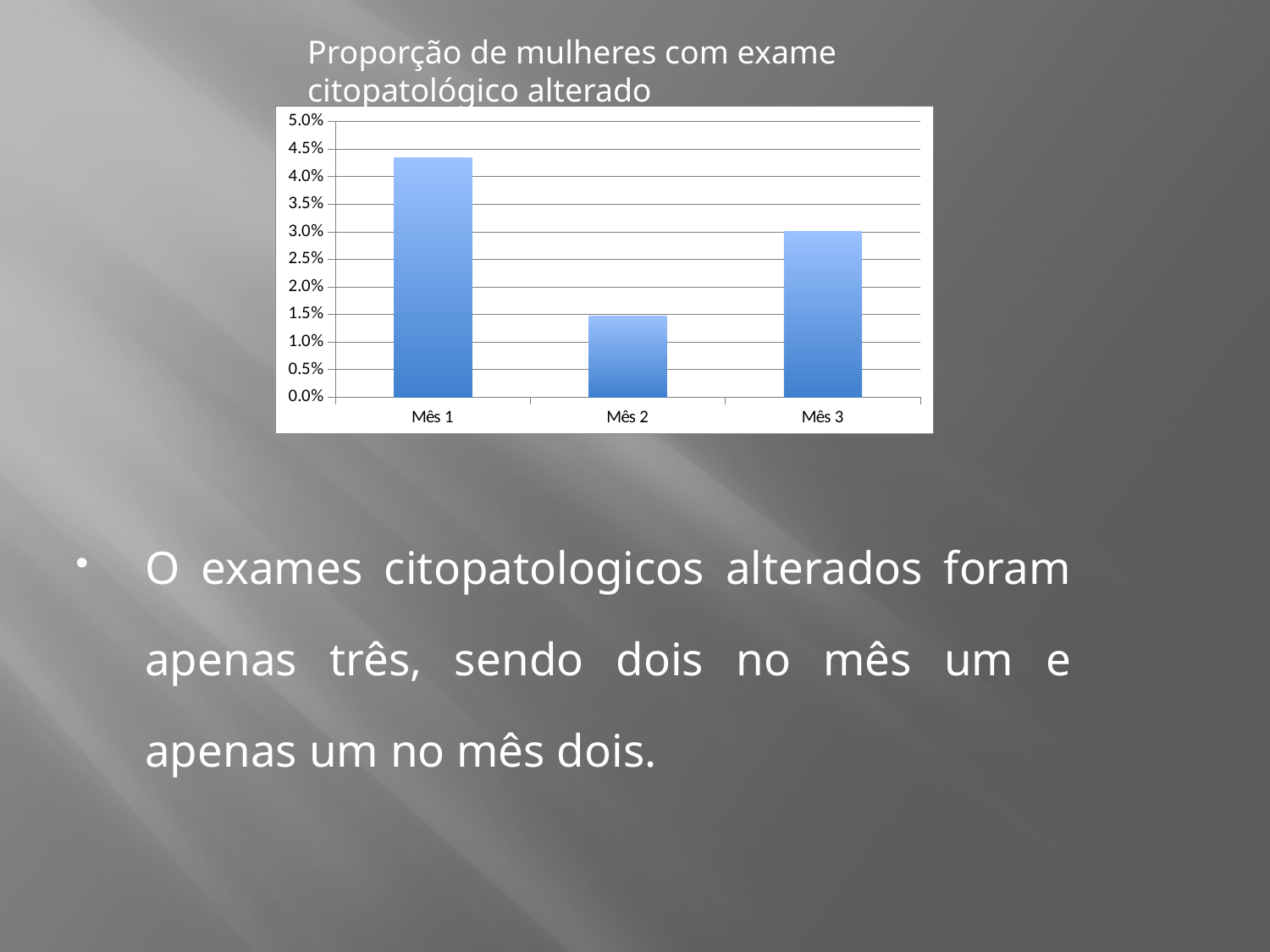
Is the value for Mês 2 greater or less than 2.0%? less Does the value rise or fall from Mês 1 to Mês 2? fall Is the value for Mês 1 greater or less than 4.0%? greater Which is larger, the value for Mês 1 or the value for Mês 3? Mês 1 What is the highest value shown on the y axis of the chart? 5.0% Is the value for Mês 3 greater or less than 2.5%? greater Which month has the lowest proportion in the chart? Mês 2 How many categories are shown on the x axis of the chart? 3 What is the title of the chart? Proporção de mulheres com exame citopatológico alterado Which month has the highest proportion in the chart? Mês 1 What kind of chart is shown on the slide? bar chart Which is larger, the value for Mês 2 or the value for Mês 3? Mês 3